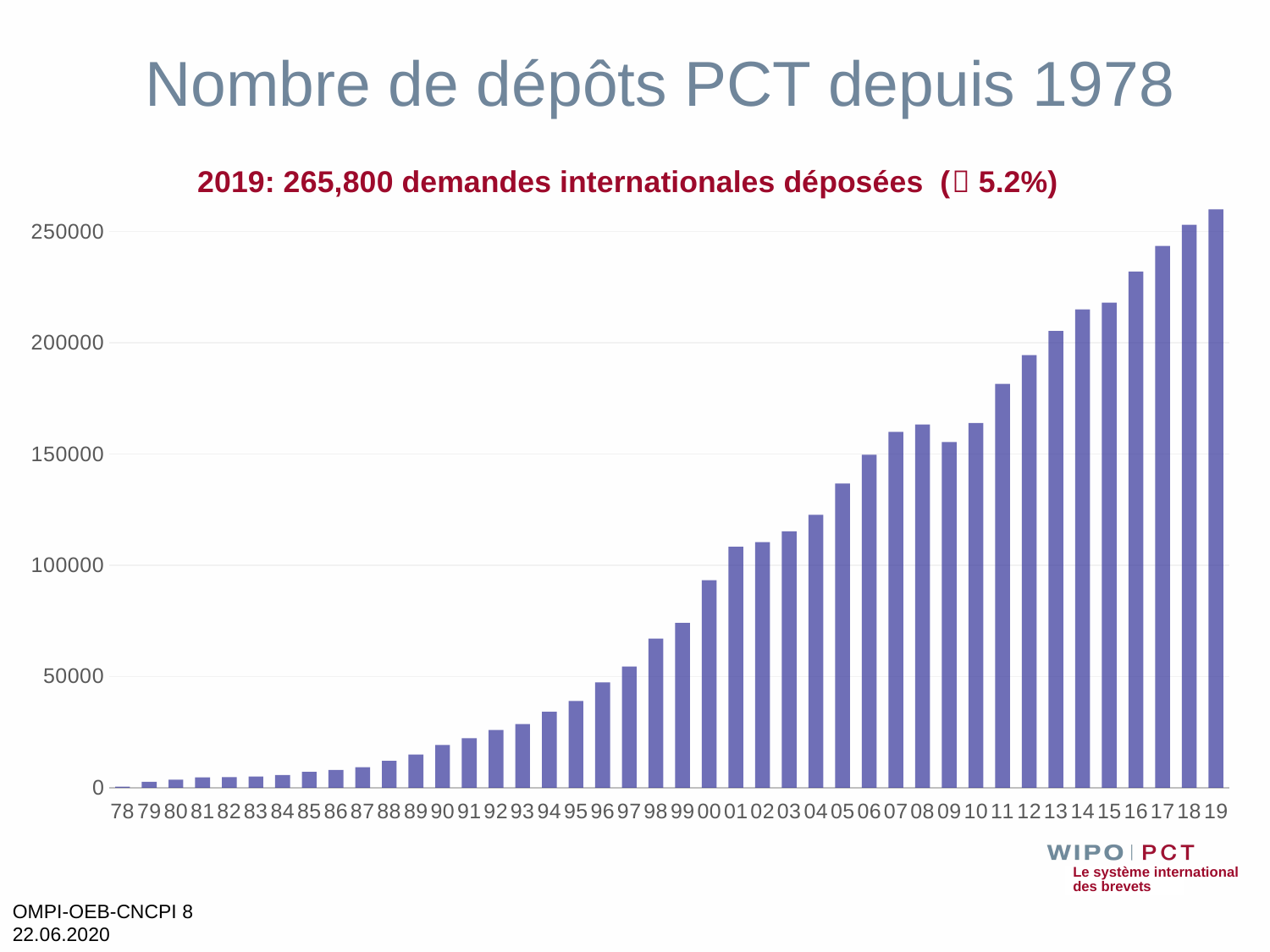
What is the title of the chart? Nombre de dépôts PCT depuis 1978 How many years (bars) are plotted on the chart? 42 Do the values generally rise or fall from 1978 to 2019? rise Is the value for 2010 greater or less than 150000? greater Is the value for 2000 greater or less than 100000? less According to the slide, how many international applications were filed in 2019? 265,800 Which year has more PCT filings, 2008 or 2009? 2008 Is the value for 1995 greater or less than 50000? less Which year has the highest number of PCT filings? 19 What kind of chart is shown on the slide? bar chart Which year has the lowest number of PCT filings? 78